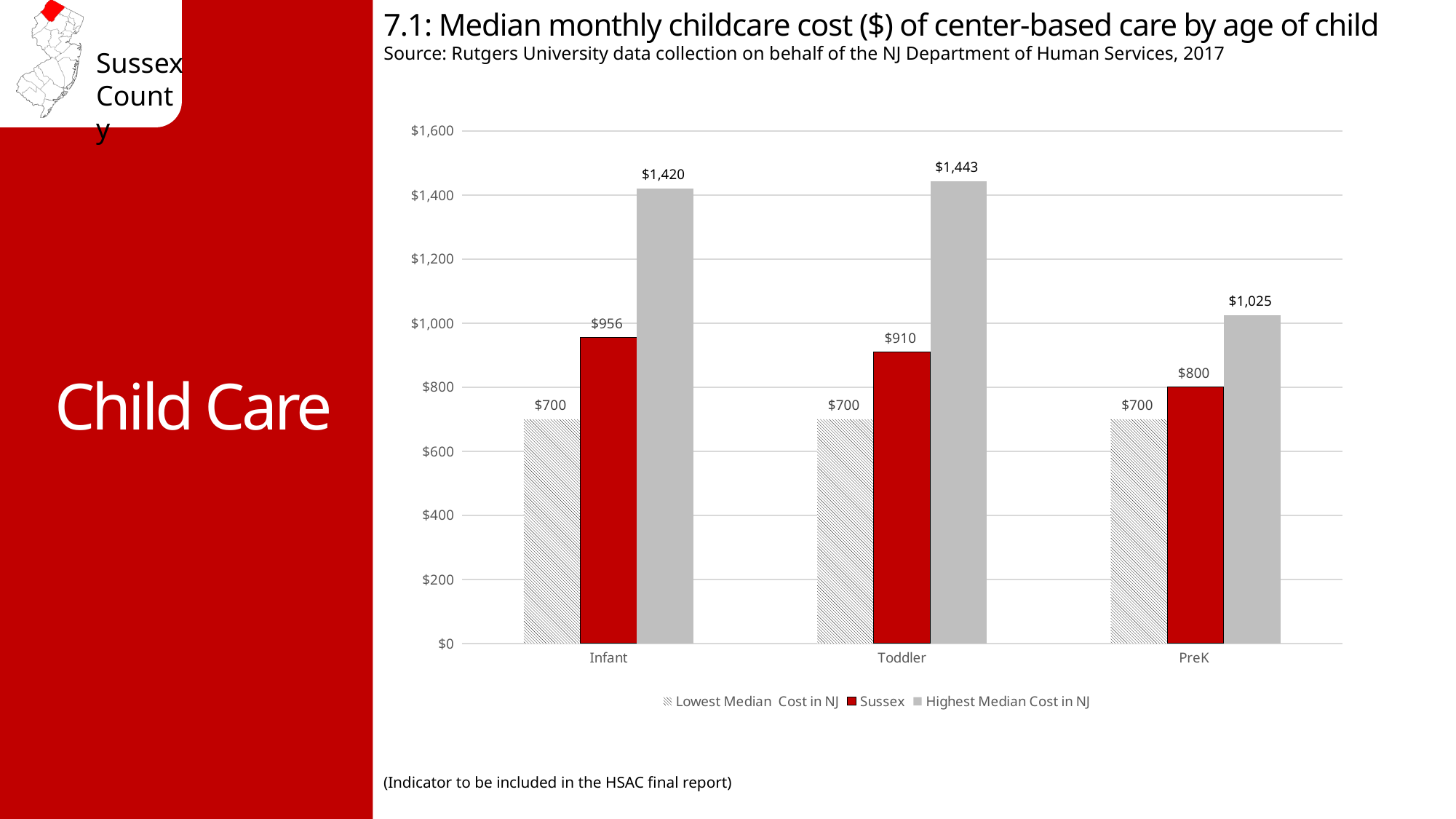
Is the Highest Median Cost in NJ for PreK care greater or less than $1,200? less What is the Sussex median monthly childcare cost for Infant care? $956 How many age groups are shown on the x axis? 3 Which age group has the lowest Highest Median Cost in NJ? PreK What is the Highest Median Cost in NJ for Toddler care? $1,443 What is the difference between the Sussex cost for Toddler care and the Sussex cost for PreK care? $110 How many series does the legend list? 3 What is the Lowest Median Cost in NJ for PreK care? $700 Which is larger: the Sussex cost for Toddler care or the Sussex cost for PreK care? Toddler What is the difference between the Highest Median Cost in NJ and the Sussex cost for Infant care? $464 What kind of chart is shown on the slide? Bar chart Which age group has the highest Sussex median monthly cost? Infant